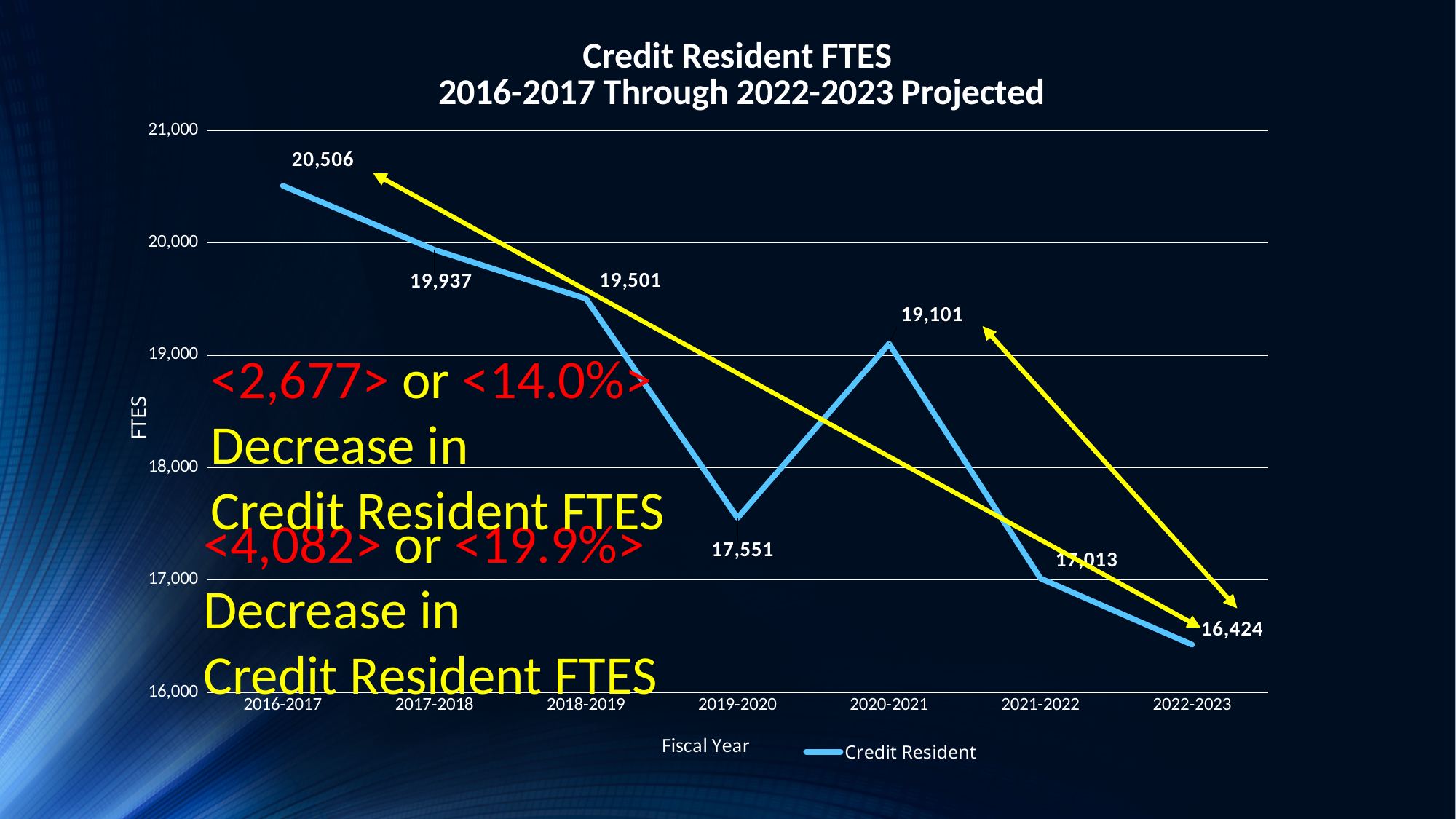
What is the Credit Resident FTES value for 2019-2020? 17,551 What is the title of the chart? Credit Resident FTES 2016-2017 Through 2022-2023 Projected What is the Credit Resident FTES value for 2016-2017? 20,506 Which fiscal year has the lowest Credit Resident FTES? 2022-2023 What is the projected Credit Resident FTES value for 2022-2023? 16,424 What kind of chart is shown on the slide? Line chart Which fiscal year has the highest Credit Resident FTES? 2016-2017 What is the difference in Credit Resident FTES between 2016-2017 and 2022-2023? 4,082 Which fiscal year has a higher Credit Resident FTES, 2020-2021 or 2021-2022? 2020-2021 What is the Credit Resident FTES value for 2020-2021? 19,101 How many fiscal years are plotted on the chart? 7 What is the difference in Credit Resident FTES between 2018-2019 and 2019-2020? 1,950